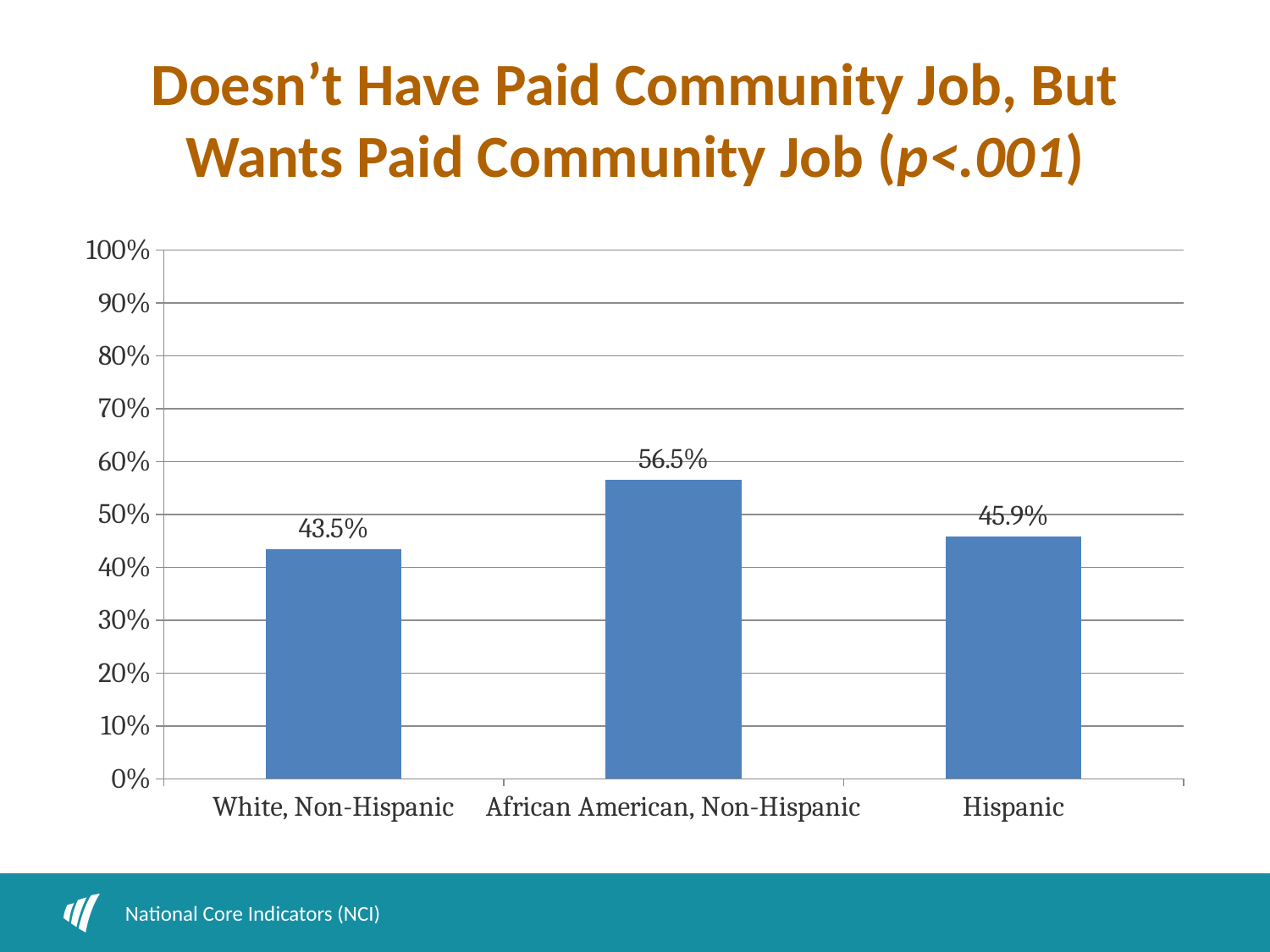
What is the value for White, Non-Hispanic? 43.5% What is the difference between the values for Hispanic and White, Non-Hispanic? 2.4% How many categories are shown on the x axis? 3 Which is larger, the value for Hispanic or the value for African American, Non-Hispanic? African American, Non-Hispanic What is the value for Hispanic? 45.9% What is the highest value shown on the y axis? 100% What is the difference between the values for African American, Non-Hispanic and White, Non-Hispanic? 13.0% What kind of chart is shown on the slide? bar chart Which category has the lowest value? White, Non-Hispanic Which category has the highest value? African American, Non-Hispanic What is the value for African American, Non-Hispanic? 56.5% Is the value for African American, Non-Hispanic greater or less than 50%? greater